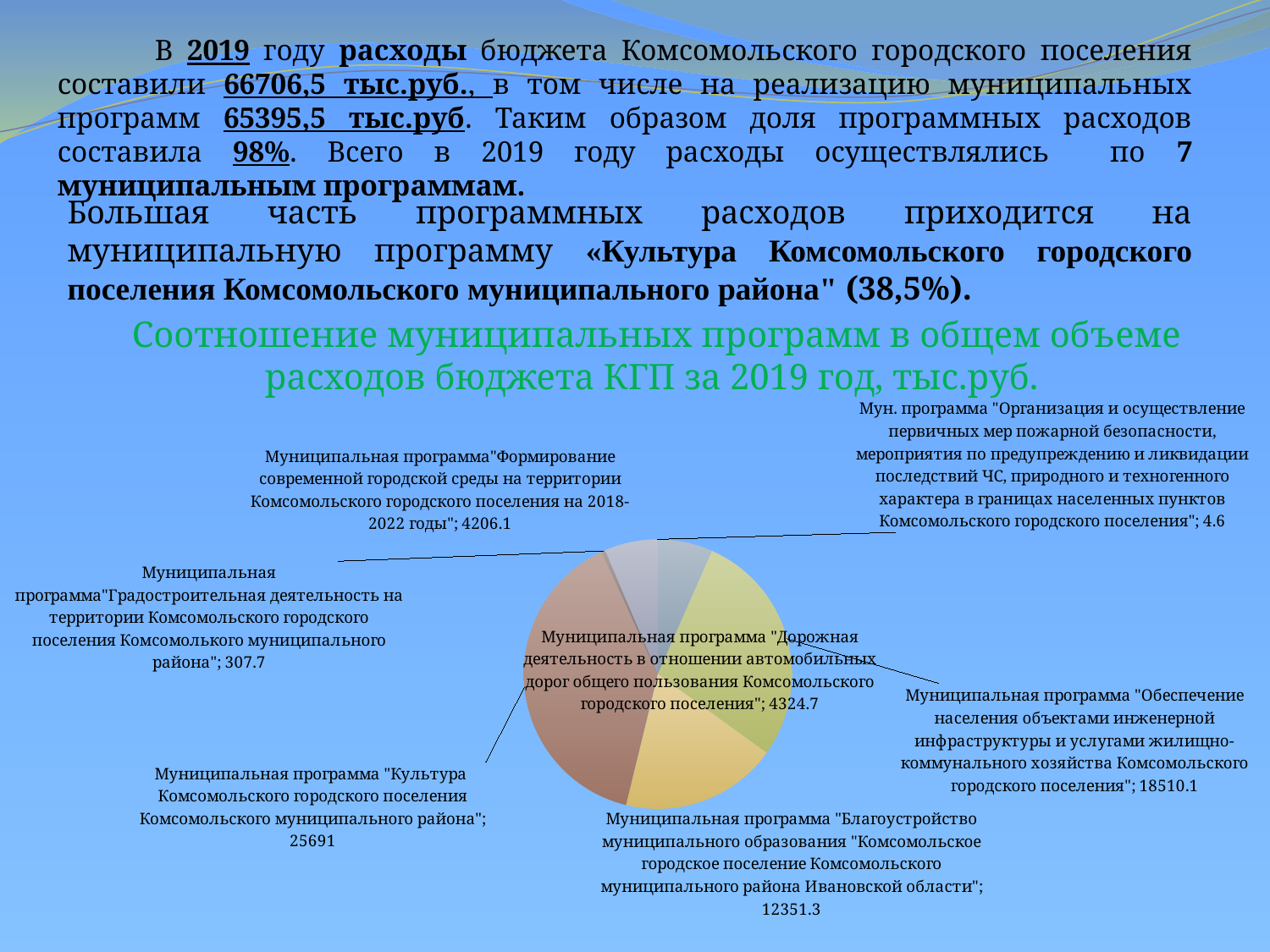
What is the value for the municipal program "Благоустройство муниципального образования "Комсомольское городское поселение Комсомольского муниципального района Ивановской области"? 12351.3 What is the title of the pie chart? Соотношение муниципальных программ в общем объеме расходов бюджета КГП за 2019 год, тыс.руб. What type of chart is shown on the slide? pie chart Which municipal program has the smallest value in the pie chart? Организация и осуществление первичных мер пожарной безопасности How many municipal programs (slices) are shown in the pie chart? 7 Which has a larger value: the "Формирование современной городской среды" program or the "Дорожная деятельность" program? Дорожная деятельность What is the value for the municipal program "Культура Комсомольского городского поселения Комсомольского муниципального района"? 25691 What is the difference between the values for the "Формирование современной городской среды" program and the "Градостроительная деятельность" program? 3898.4 What is the value for the municipal program "Организация и осуществление первичных мер пожарной безопасности..."? 4.6 Which municipal program has the largest value in the pie chart? Культура Комсомольского городского поселения Комсомольского муниципального района What is the value for the municipal program "Дорожная деятельность в отношении автомобильных дорог общего пользования Комсомольского городского поселения"? 4324.7 What is the difference between the values for the "Культура" program and the "Обеспечение населения объектами инженерной инфраструктуры" program? 7180.9